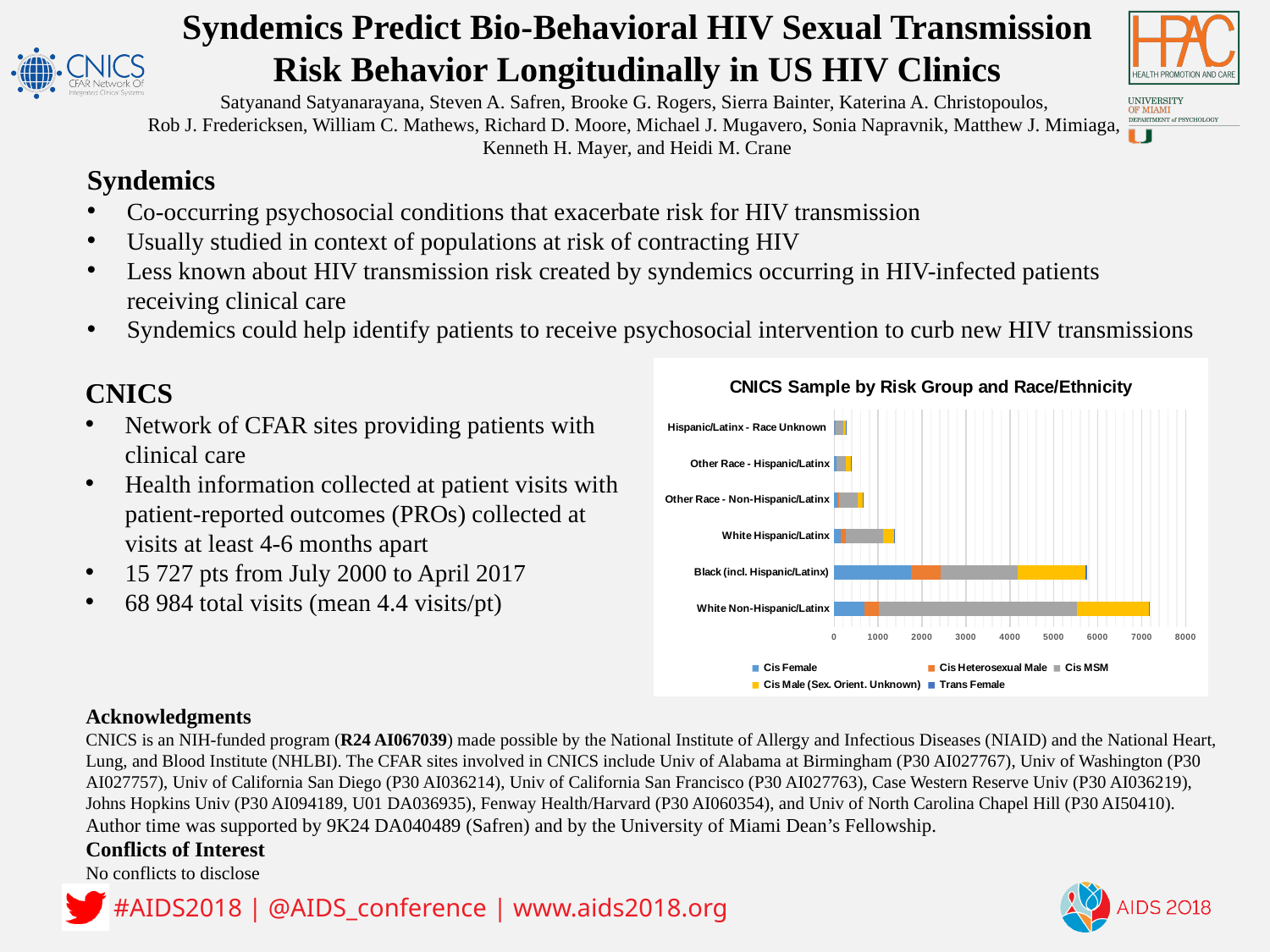
Which colour represents the Cis MSM series in the chart? Gray Is the total bar for White Hispanic/Latinx greater or less than 1000? greater How many risk-group series does the chart legend list? 5 Is the total bar for Hispanic/Latinx - Race Unknown greater or less than 1000? less How many race/ethnicity categories are plotted in the chart? 6 What kind of chart is shown on the slide? Stacked bar chart What is the title of the chart on the slide? CNICS Sample by Risk Group and Race/Ethnicity Which has a larger total bar: Black (incl. Hispanic/Latinx) or White Hispanic/Latinx? Black (incl. Hispanic/Latinx) Is the total bar for Black (incl. Hispanic/Latinx) greater or less than 5000? greater Which race/ethnicity category has the largest total bar in the chart? White Non-Hispanic/Latinx